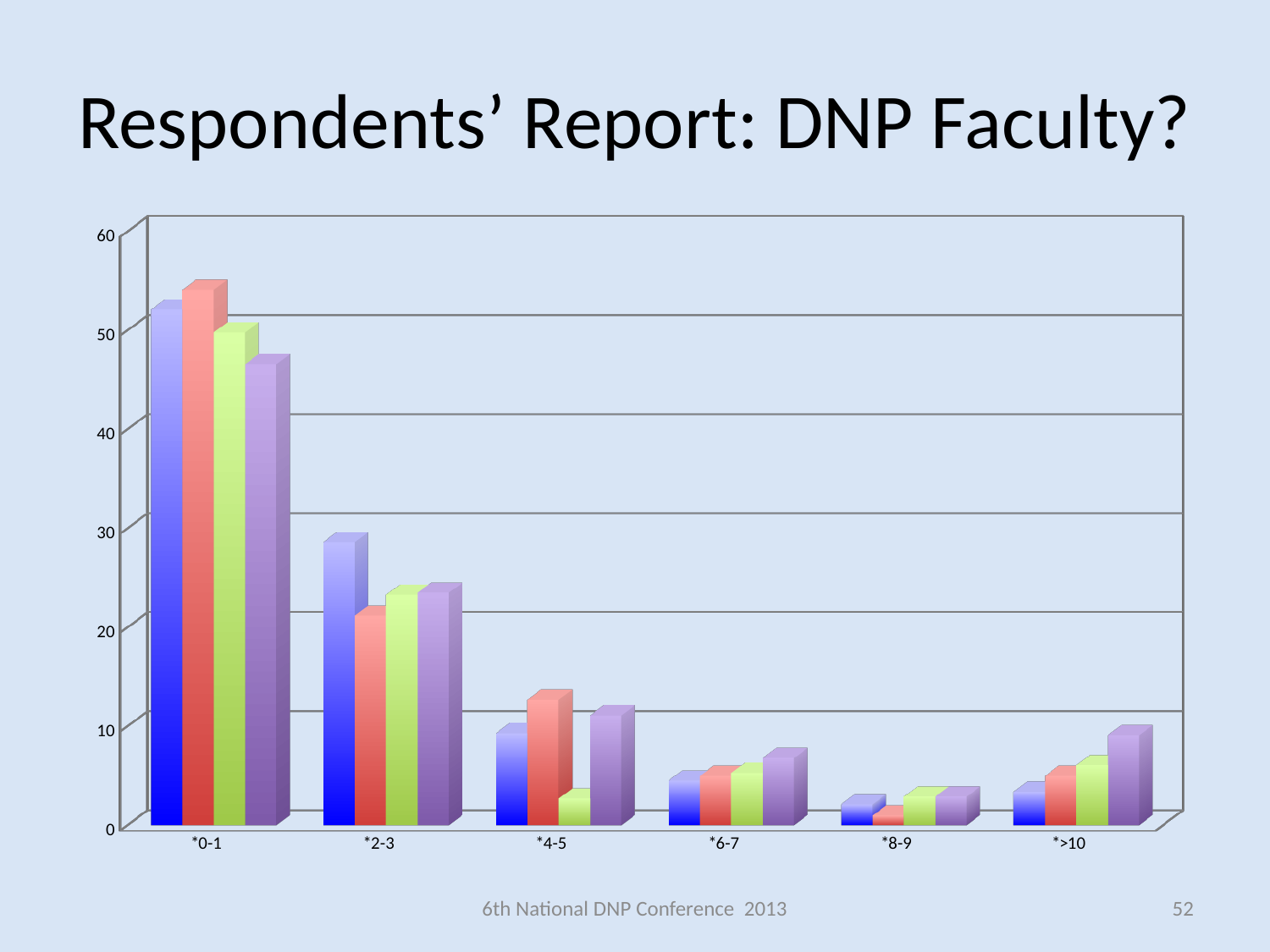
How many bars are plotted for each category? 4 Is the value of the red bar for *0-1 greater or less than 50? greater Do the bar heights generally rise or fall moving from *0-1 to *8-9 along the x axis? fall How many categories are shown along the x axis? 6 What kind of chart is shown on the slide? bar chart Which category has the tallest bars? *0-1 Which category has the shortest bars overall? *8-9 What is the title of the slide containing the chart? Respondents' Report: DNP Faculty? Which is larger, the blue bar for *0-1 or the blue bar for *2-3? the blue bar for *0-1 Is the value of the green bar for *4-5 greater or less than 10? less Is the value of the red bar for *4-5 greater or less than 10? greater